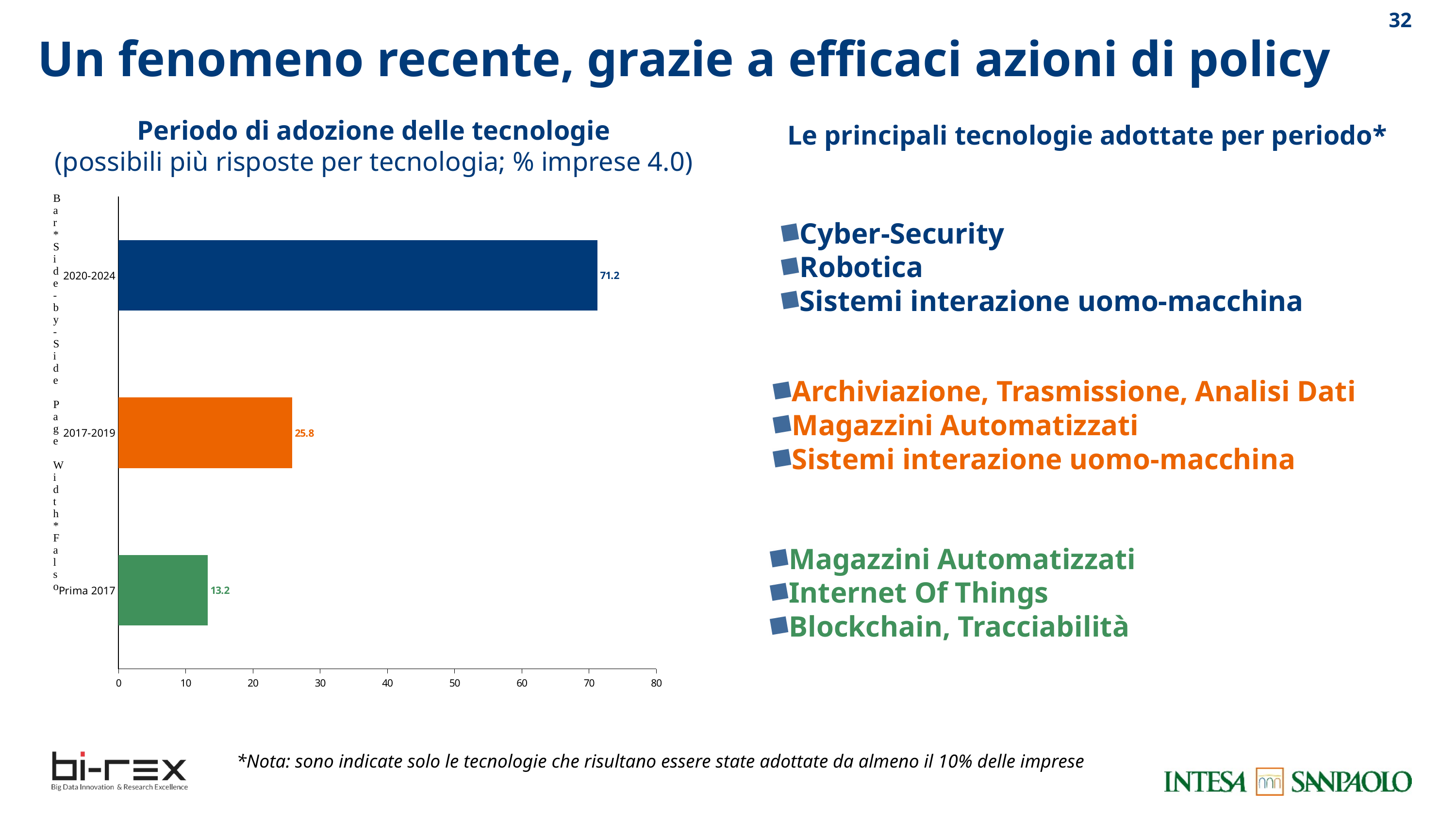
What is the value for 2017-2019? 25.8 What is the value for Prima 2017? 13.2 Which period has the highest value? 2020-2024 What is the value for 2020-2024? 71.2 What is the difference between the values for 2017-2019 and Prima 2017? 12.6 Is the value for 2020-2024 greater or less than 70? greater What is the title of the chart? Periodo di adozione delle tecnologie What is the difference between the values for 2020-2024 and 2017-2019? 45.4 What kind of chart is shown on the slide? bar chart How many periods are shown in the chart? 3 Which period has the lowest value? Prima 2017 Which is larger, the value for 2017-2019 or the value for Prima 2017? 2017-2019